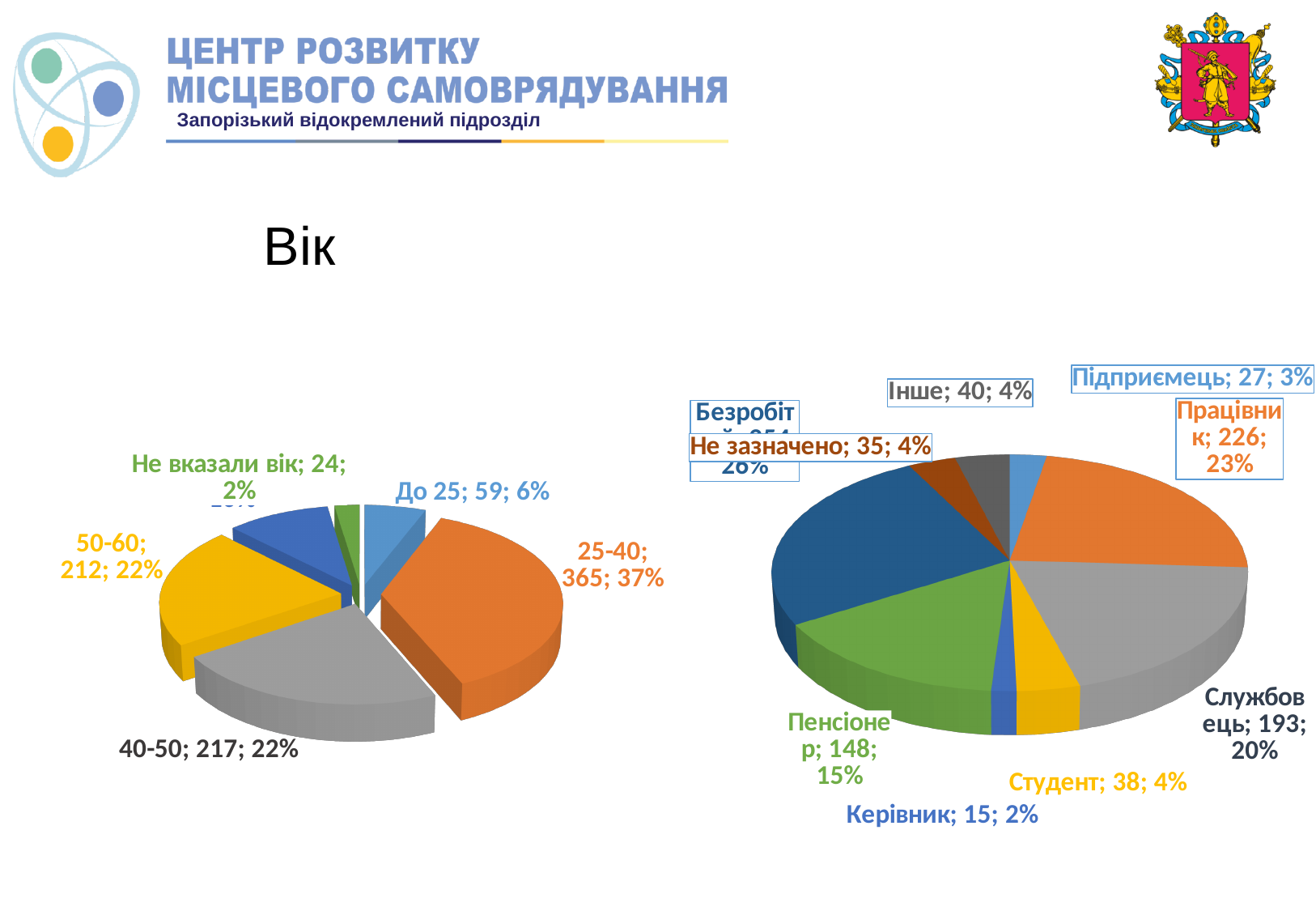
On the left pie chart (Вік), what percentage is shown for the 'До 25' slice? 6% On the right pie chart, which category has the smallest slice? Керівник On the right pie chart, what value is shown for 'Службовець'? 193; 20% On the left pie chart (Вік), what value is shown for the 25-40 age group? 365; 37% On the right pie chart, which is larger: the count for 'Студент' or for 'Підприємець'? Студент On the right pie chart, what is the difference between the counts for 'Працівник' and 'Службовець'? 33 On the left pie chart (Вік), which is larger: the count for 'До 25' or for 'Не вказали вік'? До 25 On the left pie chart (Вік), how many slices does the pie have? 6 On the right pie chart, what count is shown for 'Пенсіонер'? 148 What type of chart is used on the left side of the slide? Pie chart On the left pie chart (Вік), which age category has the largest slice? 25-40 On the left pie chart (Вік), what is the difference between the counts for 40-50 and 50-60? 5